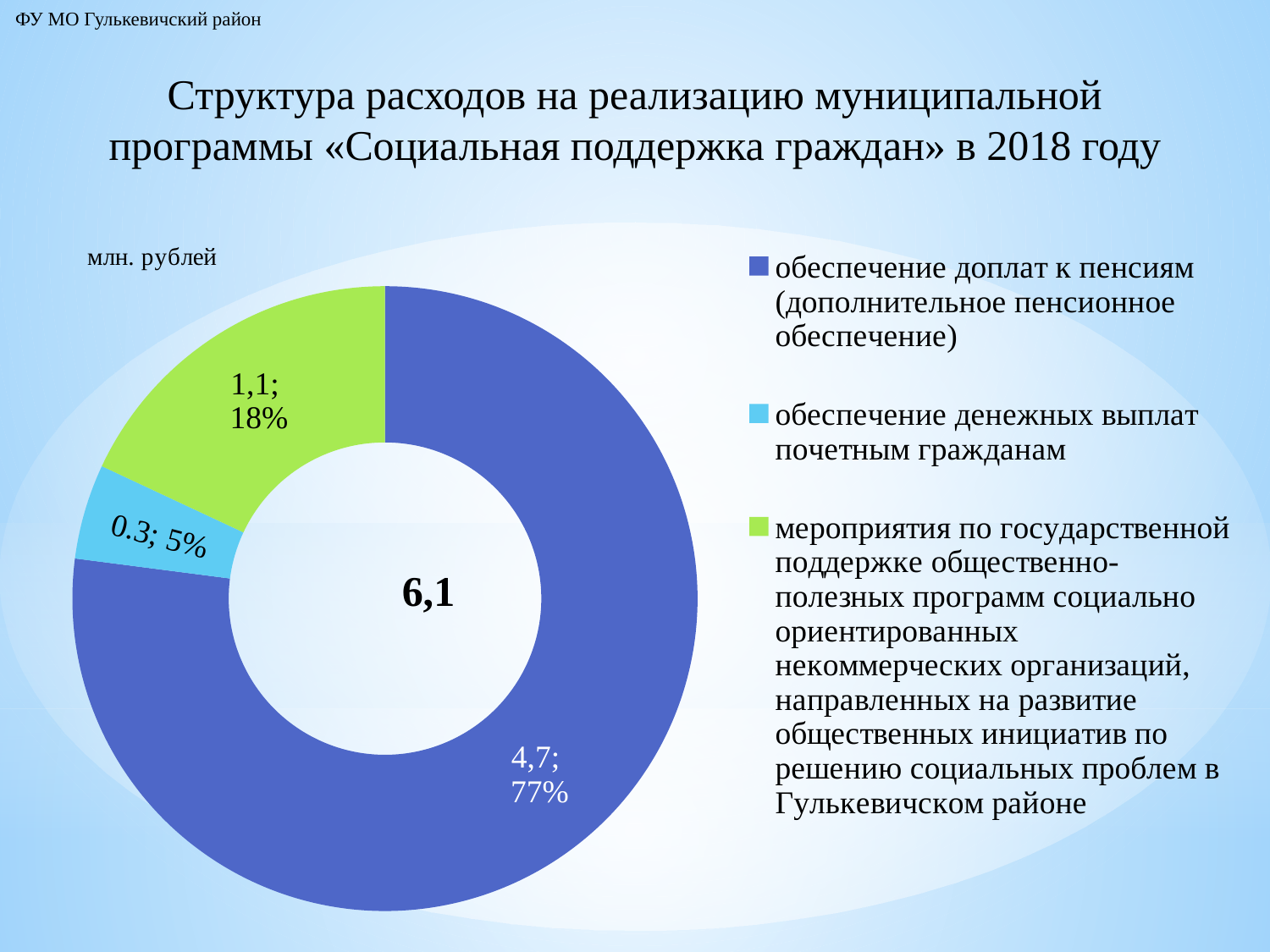
How many categories does the chart show? 3 Which category has the smallest value? обеспечение денежных выплат почетным гражданам What is the difference between the value for «обеспечение доплат к пенсиям» and the value for «мероприятия по государственной поддержке...»? 3,6 What share of the chart does «обеспечение доплат к пенсиям» take? 77% What kind of chart is shown on the slide? Doughnut (pie) chart What is the value for «обеспечение денежных выплат почетным гражданам»? 0,3 What share of the chart does the green slice (мероприятия по государственной поддержке...) take? 18% What total value is shown in the centre of the chart? 6,1 What share of the chart does «обеспечение денежных выплат почетным гражданам» take? 5% What is the value for «обеспечение доплат к пенсиям (дополнительное пенсионное обеспечение)»? 4,7 What is the value for «мероприятия по государственной поддержке общественно-полезных программ социально ориентированных некоммерческих организаций...»? 1,1 Which category has the largest value? обеспечение доплат к пенсиям (дополнительное пенсионное обеспечение)